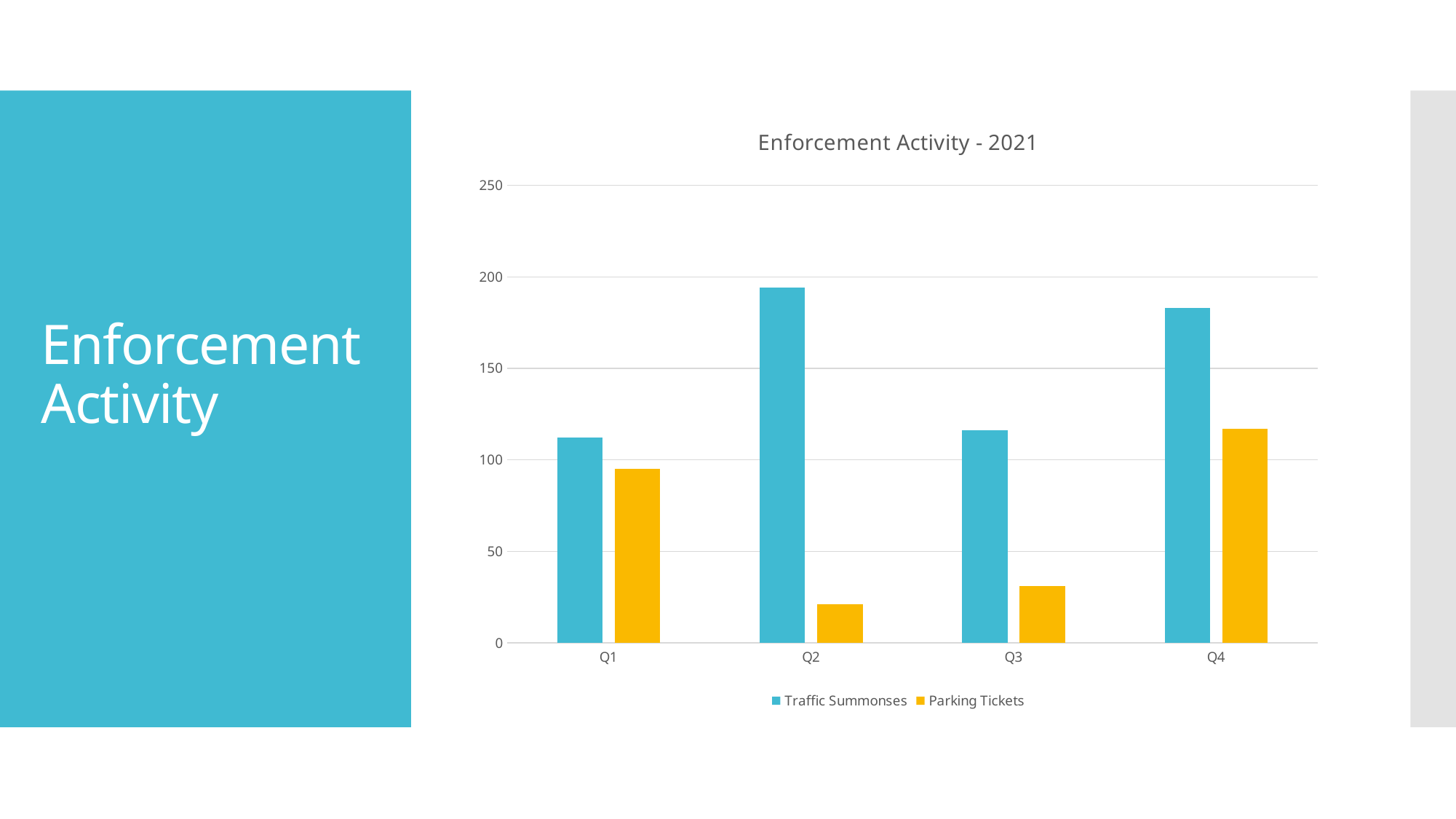
Which colour represents Parking Tickets in the chart? yellow Is the value for Traffic Summonses in Q2 greater or less than 150? greater How many quarters are shown on the x axis? 4 Is the value for Parking Tickets in Q4 greater or less than 100? greater In which quarter are Parking Tickets lowest? Q2 In which quarter are Parking Tickets highest? Q4 What is the title of the chart? Enforcement Activity - 2021 What kind of chart is shown on the slide? bar chart How many series does the legend list? 2 In Q1, which is larger: Traffic Summonses or Parking Tickets? Traffic Summonses In which quarter are Traffic Summonses highest? Q2 Is the value for Parking Tickets in Q2 greater or less than 50? less